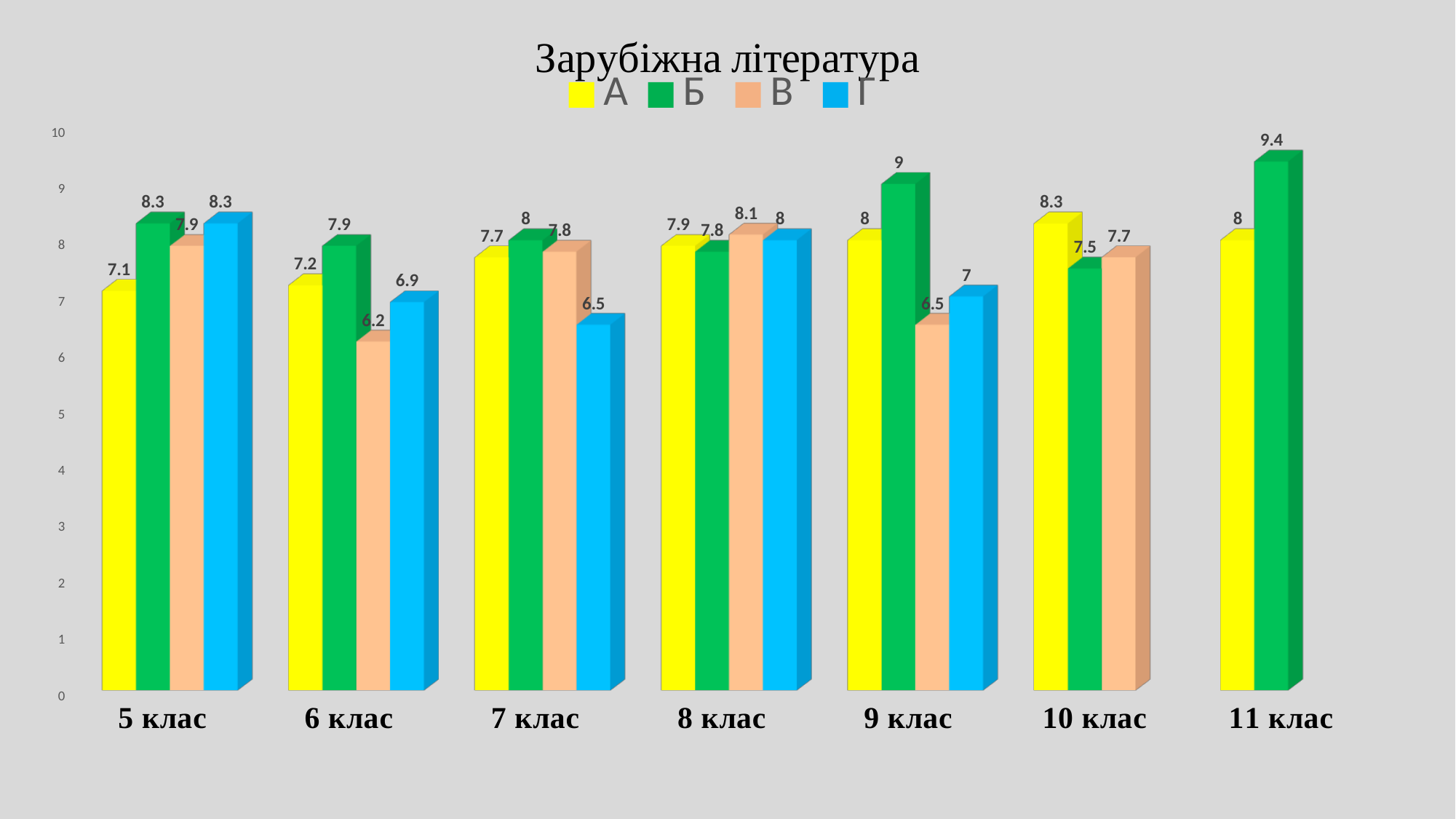
What kind of chart is shown on the slide? bar chart Which class has the highest value for series Б? 11 клас What is the value for series Б in 11 клас? 9.4 Which class has the lowest value for series А? 5 клас How many series does the legend list? 4 What is the difference between series Б and series В in 9 клас? 2.5 What is the value for series В in 6 клас? 6.2 Which is larger in 8 клас: series А or series В? В What is the title of the chart? Зарубіжна література How many classes (categories) are shown on the x axis? 7 What is the value for series Г in 9 клас? 7 What is the value for series А in 10 клас? 8.3